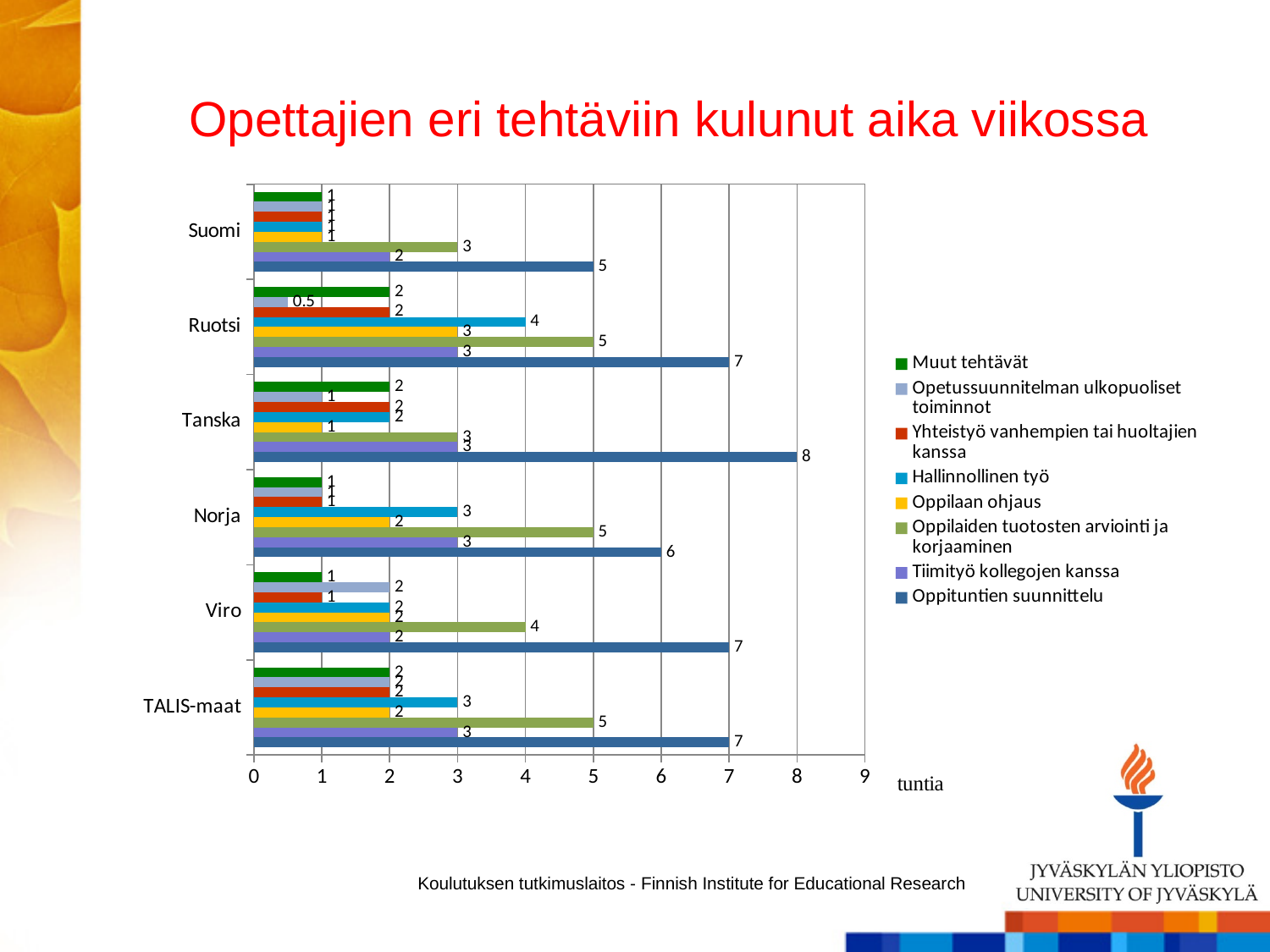
What is the value of Oppituntien suunnittelu for Tanska? 8 What is the value of Oppilaiden tuotosten arviointi ja korjaaminen for Suomi? 3 What is the value of Opetussuunnitelman ulkopuoliset toiminnot for Ruotsi? 0.5 How many categories (countries/groups) are shown on the y axis? 6 How many series does the legend list? 8 Which country has the highest value for Oppituntien suunnittelu? Tanska What kind of chart is shown on the slide? bar chart What unit label is shown next to the x axis? tuntia What is the value of Hallinnollinen työ for Ruotsi? 4 What is the difference between the Oppituntien suunnittelu values for Tanska and Suomi? 3 Which has a larger value for Oppilaiden tuotosten arviointi ja korjaaminen, Norja or Viro? Norja Which category has the lowest value for Oppituntien suunnittelu? Suomi